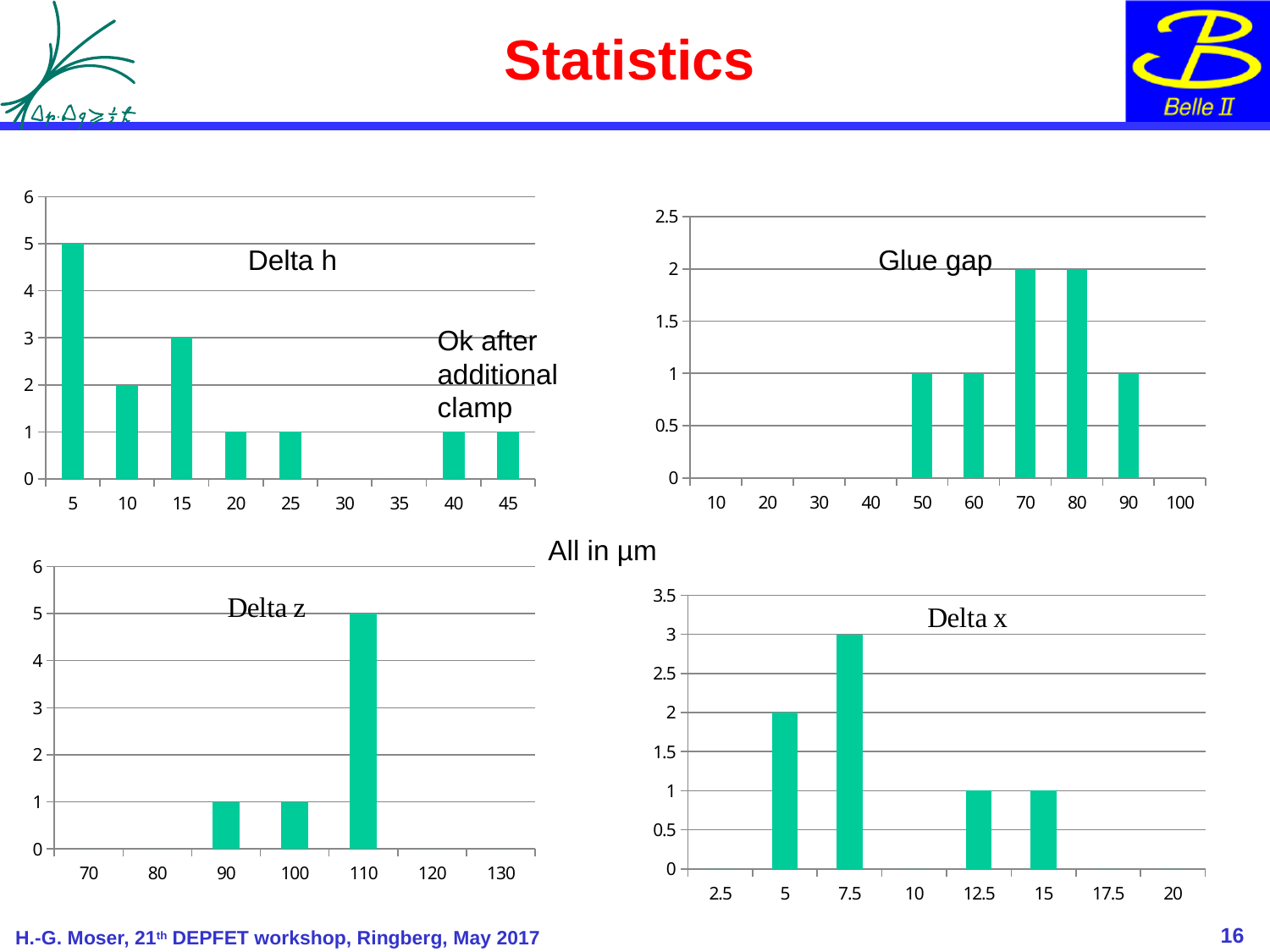
In the Delta x chart, what is the difference between the values for the 7.5 bin and the 5 bin? 1 In the Delta x chart, what is the value for the 7.5 bin? 3 In the Delta z chart, which bin has the highest value? 110 In the Delta h chart, what is the difference between the values for the 15 bin and the 10 bin? 1 What kind of chart is the Delta x chart? bar chart In the Delta h chart, which bin has the highest value? 5 In the Delta h chart, what is the value for the 5 bin? 5 According to the slide, what unit are all the charts in? µm In the Glue gap chart, which is larger, the value for 60 or the value for 80? 80 In the Glue gap chart, how many bins are labelled on the x axis? 10 In the Glue gap chart, what is the value for the 70 bin? 2 In the Delta z chart, what is the value for the 90 bin? 1